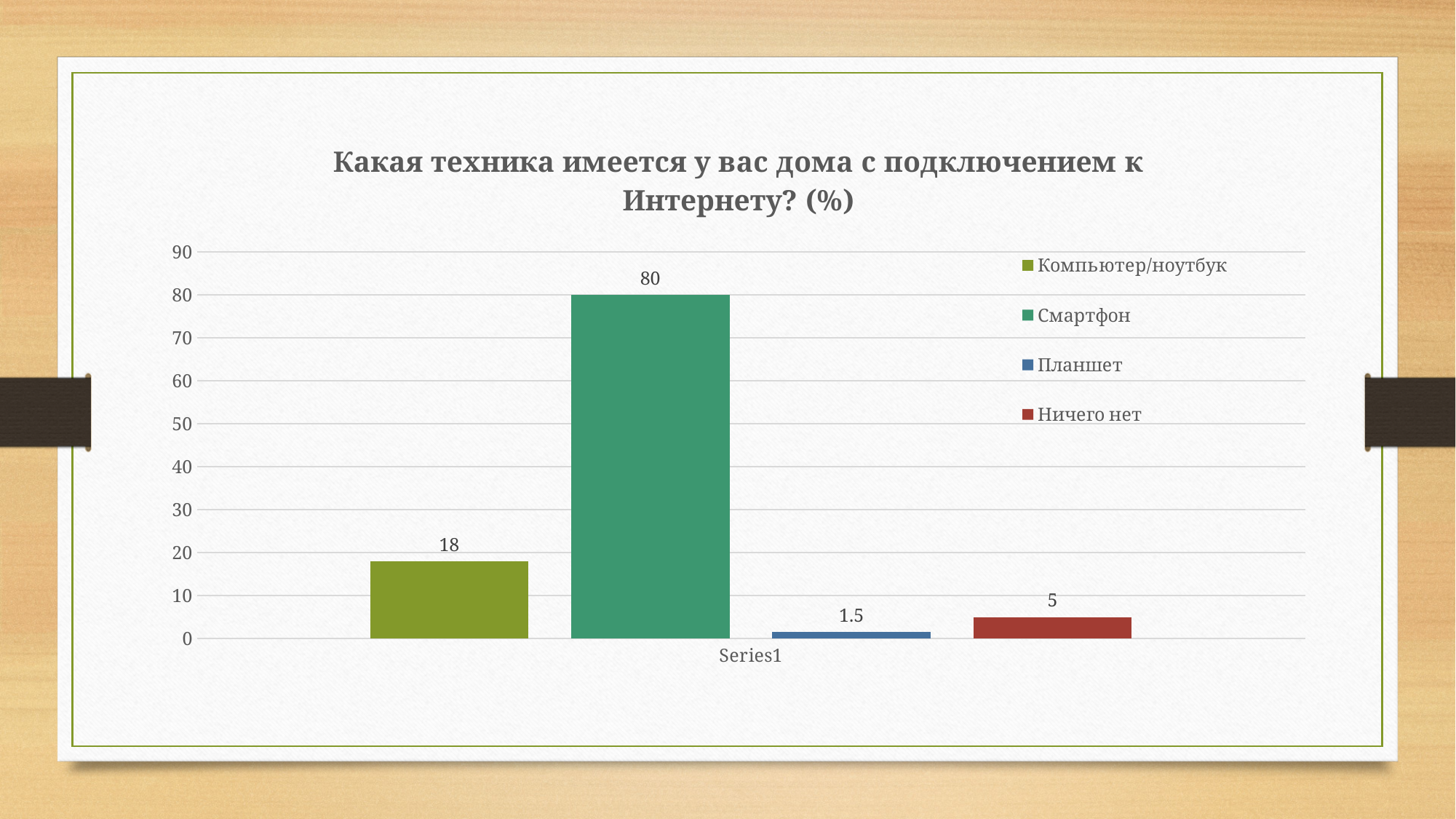
What is the value for Компьютер/ноутбук? 18 What is the value for Смартфон? 80 What is the title of the chart? Какая техника имеется у вас дома с подключением к Интернету? (%) Which is larger, the value for Компьютер/ноутбук or the value for Ничего нет? Компьютер/ноутбук How many series does the legend list? 4 What is the value for Планшет? 1.5 What is the difference between the values for Ничего нет and Планшет? 3.5 What kind of chart is shown on the slide? Bar chart Which series has the lowest value? Планшет What is the value for Ничего нет? 5 Which series has the highest value? Смартфон What is the difference between the values for Смартфон and Компьютер/ноутбук? 62